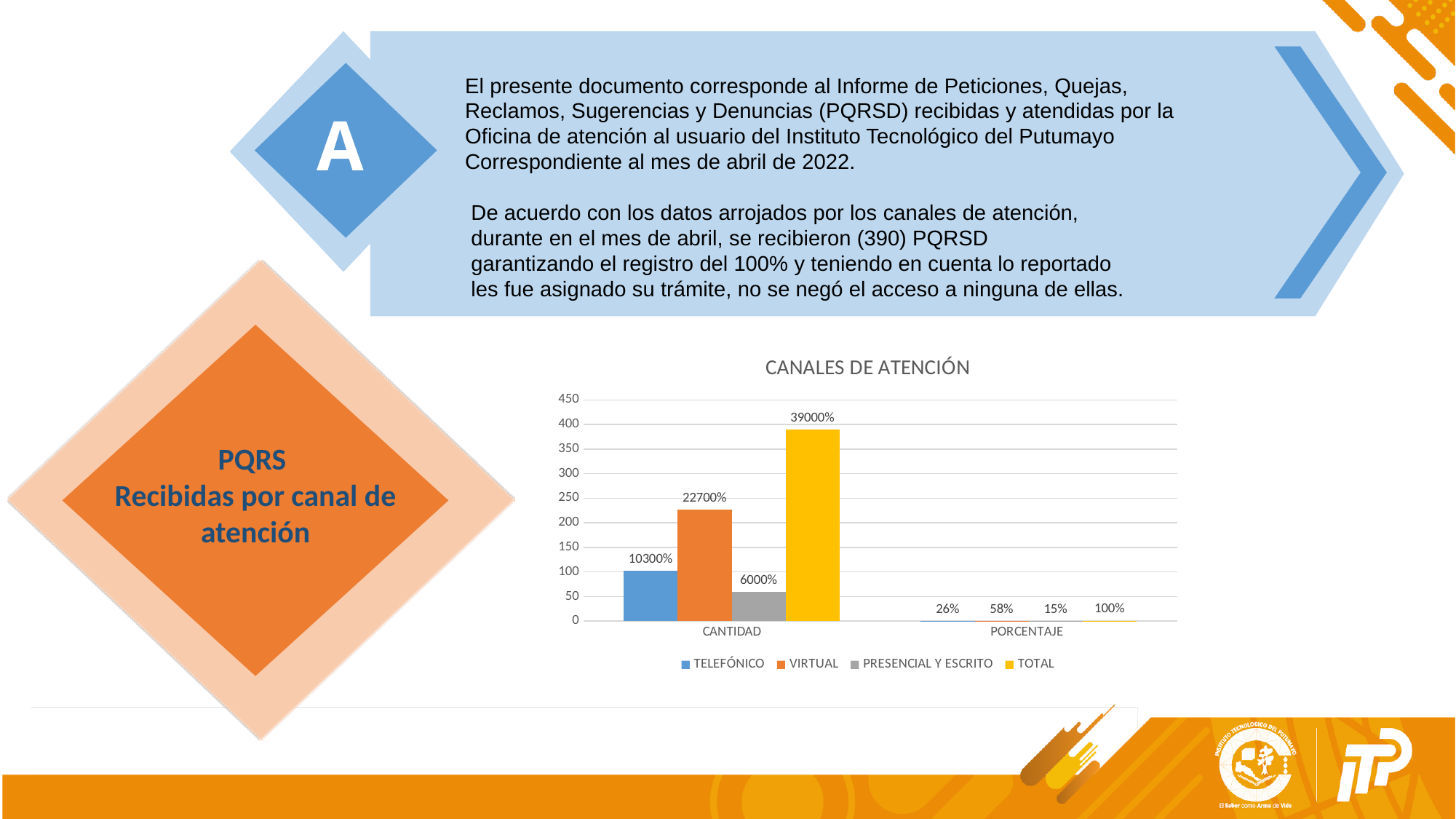
What is the data label for TOTAL in the PORCENTAJE category? 100% Which series has the tallest bar in the CANTIDAD category? TOTAL How many categories are shown on the x axis of the chart? 2 What kind of chart is shown on the slide? bar chart Which series has the shortest bar in the CANTIDAD category? PRESENCIAL Y ESCRITO How many series does the chart legend list? 4 What is the data label for PRESENCIAL Y ESCRITO in the CANTIDAD category? 6000% What is the data label for TELEFÓNICO in the CANTIDAD category? 10300% What is the data label for VIRTUAL in the PORCENTAJE category? 58% In the CANTIDAD category, which bar is taller: TELEFÓNICO or VIRTUAL? VIRTUAL What is the title of the chart? CANALES DE ATENCIÓN Is the VIRTUAL bar in the CANTIDAD category greater or less than 200 on the axis? greater